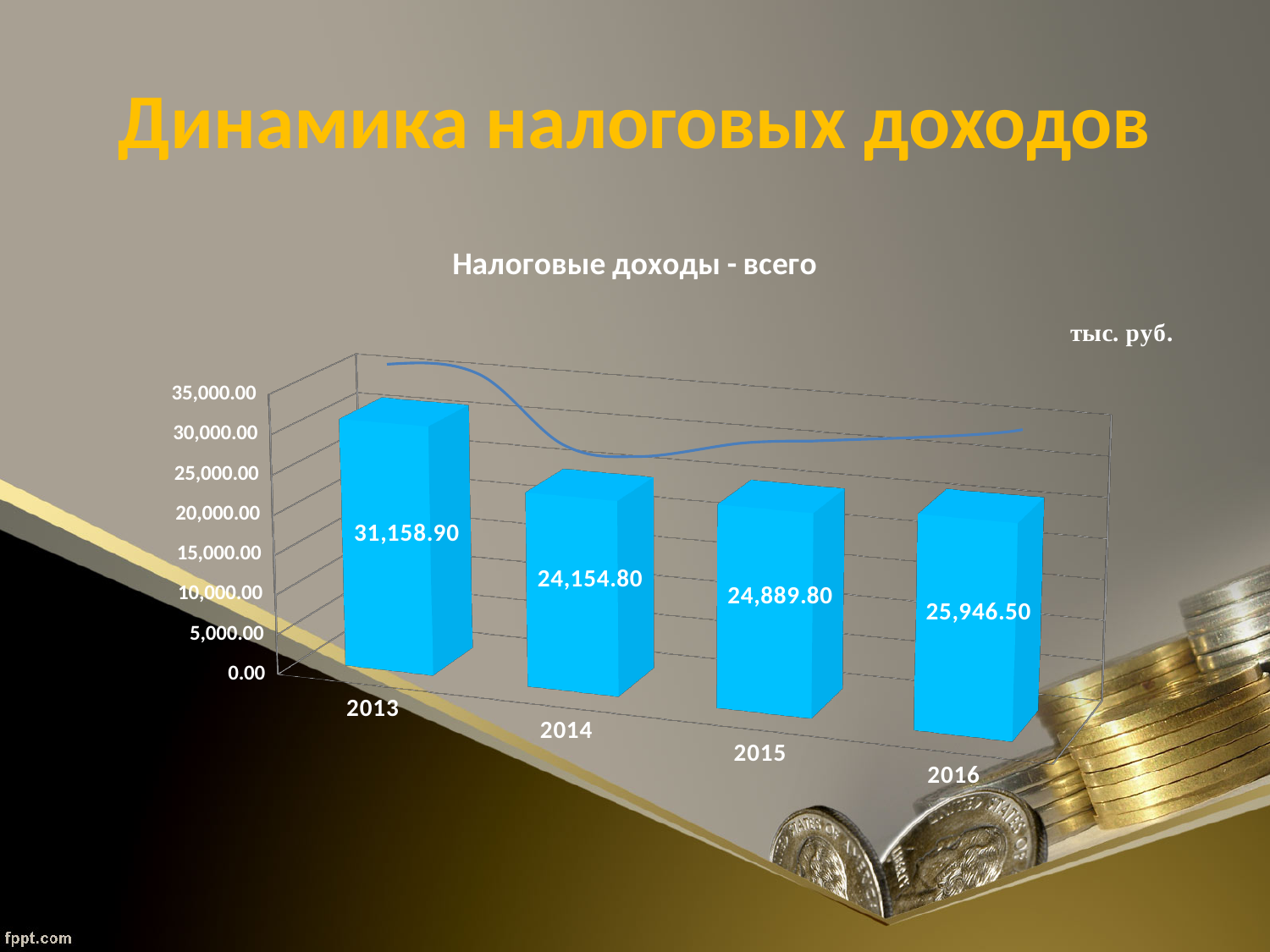
Is the value for 2013 greater or less than 30,000.00? greater What is the value for 2013 in the chart? 31,158.90 What is the difference between the values for 2013 and 2014? 7,004.10 How many years are shown on the x axis? 4 What is the value for 2016 in the chart? 25,946.50 What kind of chart is shown on the slide? bar chart What is the value for 2014 in the chart? 24,154.80 Which year has the lowest value? 2014 What is the difference between the values for 2016 and 2015? 1,056.70 From 2014 to 2016, do the values rise or fall? rise Which year has the highest value? 2013 Which is larger, the value for 2015 or the value for 2016? 2016